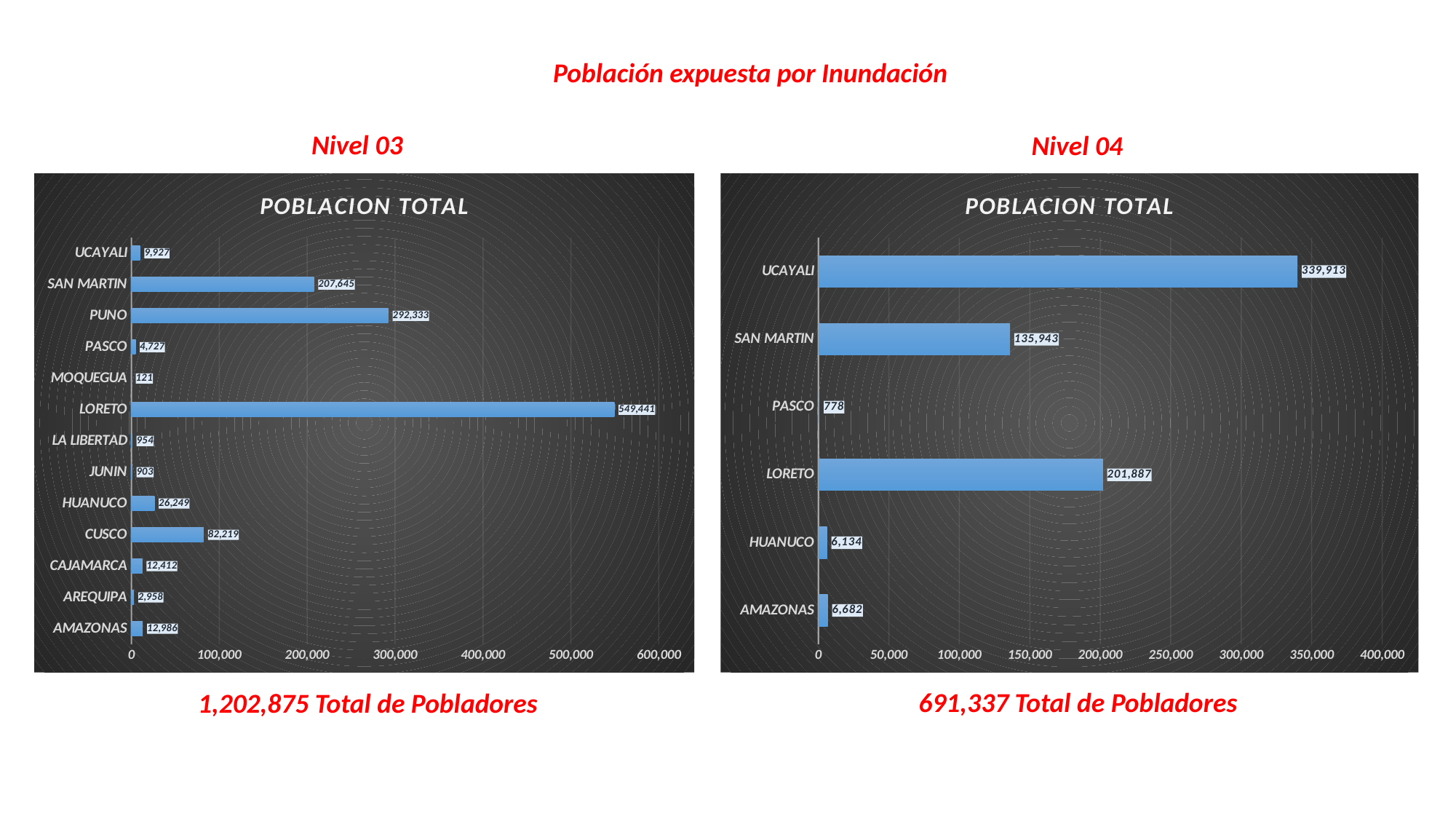
In the Nivel 04 chart (right), what is the value for SAN MARTIN? 135,943 In the Nivel 03 chart (left), what is the value for CUSCO? 82,219 In the Nivel 03 chart (left), what is the difference between the values for PUNO and SAN MARTIN? 84,688 What type of chart is used for the Nivel 04 chart (right)? Bar chart In the Nivel 04 chart (right), what is the difference between the values for UCAYALI and LORETO? 138,026 How many regions are shown in the Nivel 03 chart (left)? 13 In the Nivel 03 chart (left), which is larger, the value for HUANUCO or the value for CAJAMARCA? HUANUCO In the Nivel 03 chart (left), what is the value for LORETO? 549,441 How many regions are shown in the Nivel 04 chart (right)? 6 In the Nivel 03 chart (left), which region has the lowest value? MOQUEGUA In the Nivel 04 chart (right), which region has the lowest value? PASCO In the Nivel 04 chart (right), which region has the highest value? UCAYALI